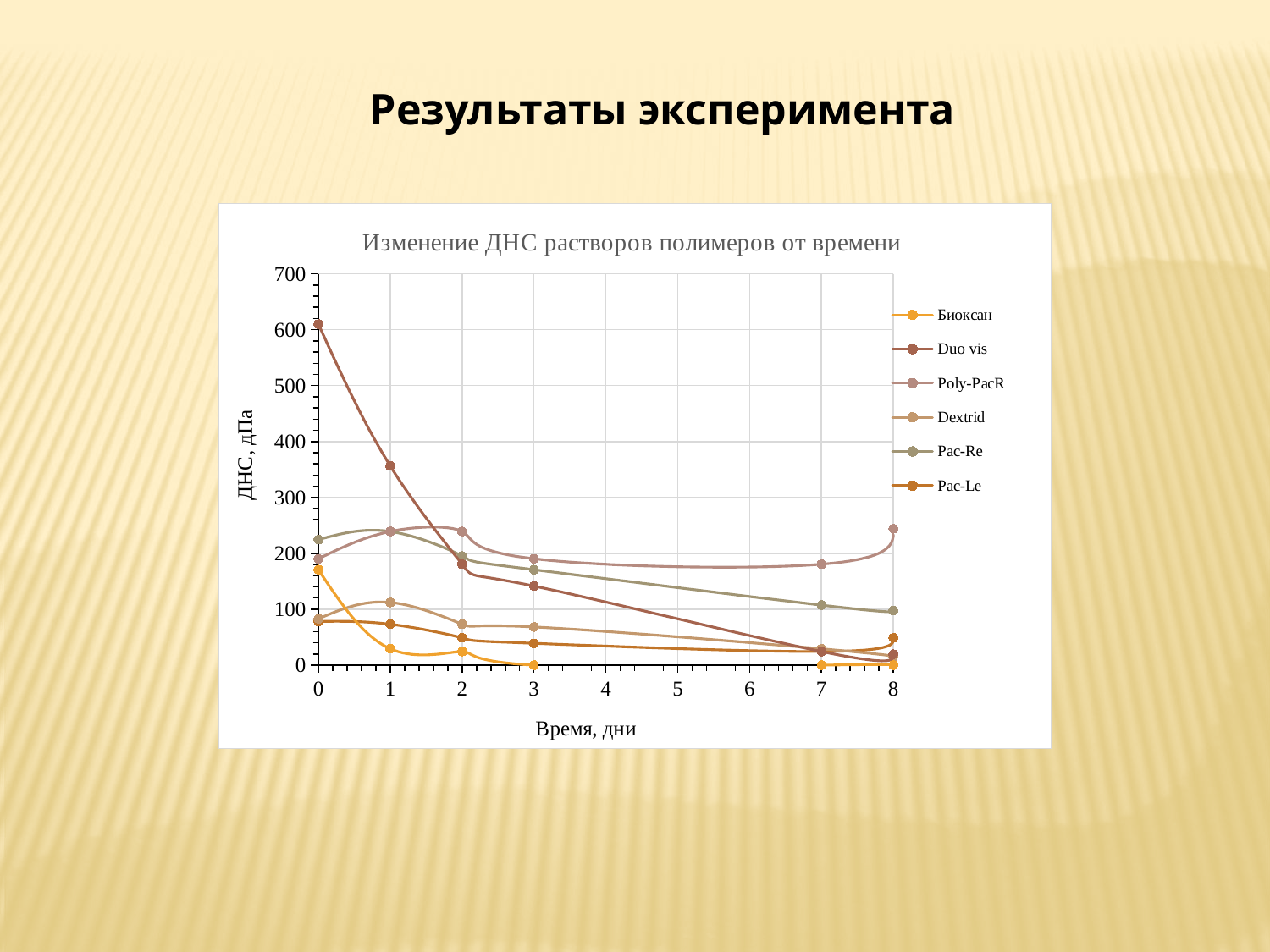
At day 1, which is larger: Duo vis or Pac-Re? Duo vis What kind of chart is shown on the slide? line chart Does the Duo vis series rise or fall from day 0 to day 8? fall How many series does the legend list? 6 Is the value for Pac-Le at day 0 greater or less than 100? less What is the title of the chart? Изменение ДНС растворов полимеров от времени Is the value for Duo vis at day 1 greater or less than 300? greater What is the label of the vertical axis? ДНС, дПа Is the value for Duo vis at day 0 greater or less than 500? greater Which series has the lowest value at day 3? Биоксан Which series has the highest value at day 0? Duo vis